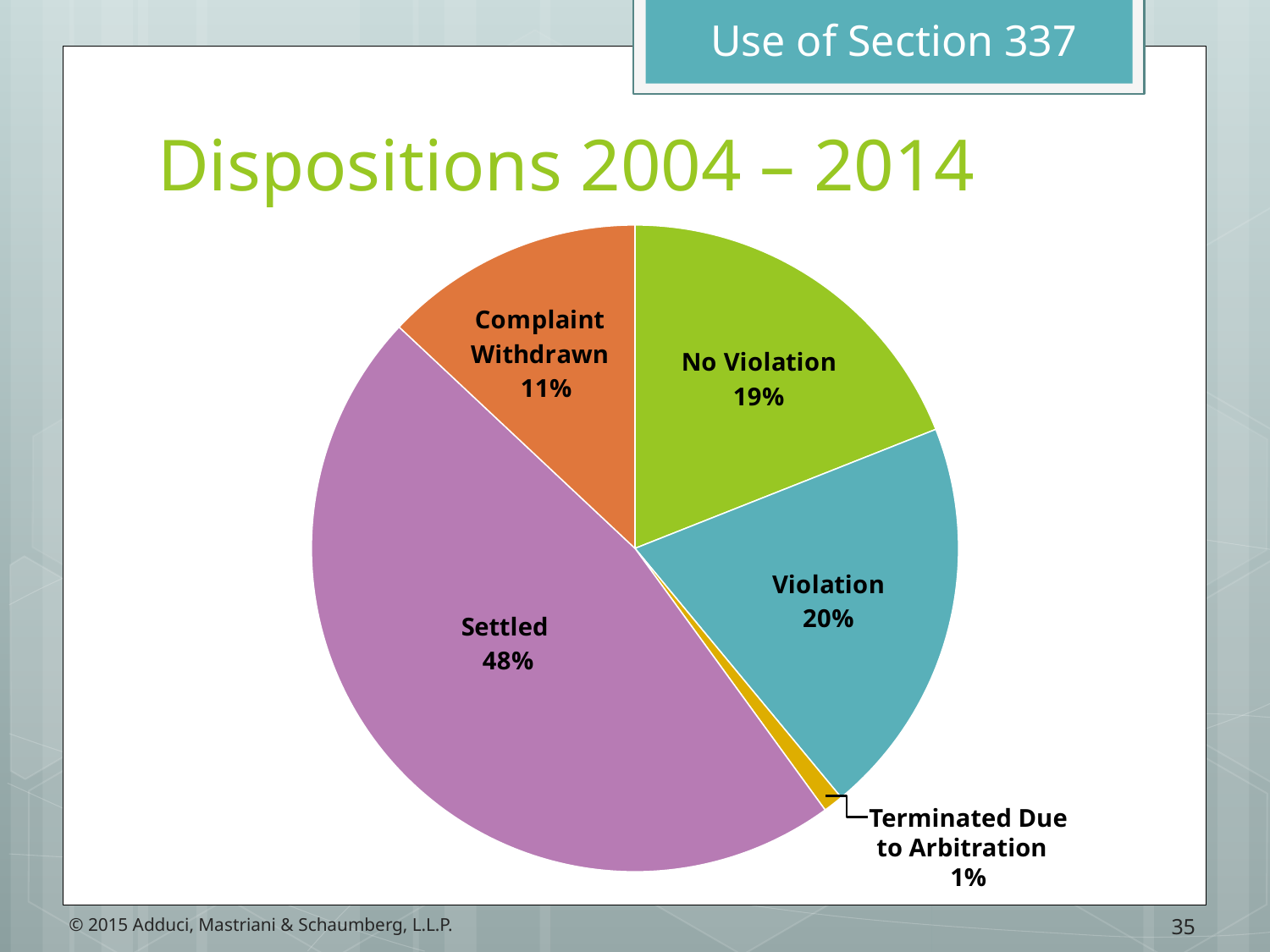
What type of chart is shown on the slide? Pie chart How many categories are shown in the pie chart? 5 Which is larger, the share for Violation or the share for No Violation? Violation What share of dispositions were Terminated Due to Arbitration? 1% What percentage of dispositions resulted in a Violation? 20% Which disposition category has the largest share of the pie? Settled What is the difference in percentage points between Settled and Violation? 28 What share of dispositions were Settled? 48% Which disposition category has the smallest share of the pie? Terminated Due to Arbitration What is the difference in percentage points between No Violation and Complaint Withdrawn? 8 What is the title of the chart? Dispositions 2004 – 2014 What percentage of dispositions were Complaint Withdrawn? 11%